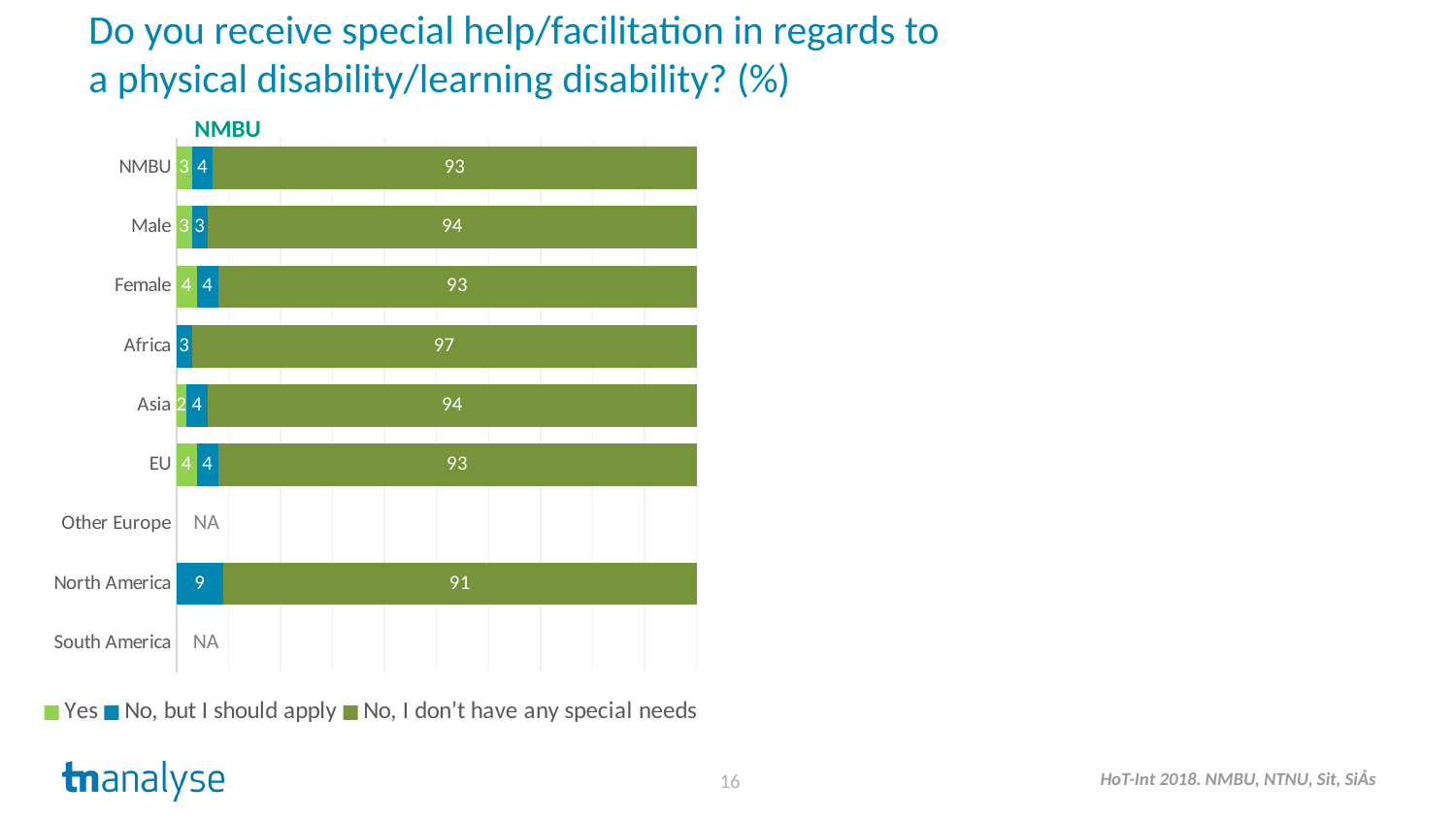
What is the difference between the 'No, I don't have any special needs' values for Africa and North America? 6 What is the total of the stacked bar for Female? 101 What is the 'Yes' value for Asia? 2 What is the value for 'No, I don't have any special needs' for Africa? 97 How many series does the legend list? 3 Which is larger, the 'No, but I should apply' value for North America or for NMBU? North America What is the 'No, I don't have any special needs' value for Male? 94 Which category has the highest value for 'No, I don't have any special needs'? Africa What is the value for 'No, but I should apply' for North America? 9 Which categories are shown as NA? Other Europe and South America Which category with data has the lowest value for 'No, I don't have any special needs'? North America What kind of chart is shown on the slide? Stacked bar chart